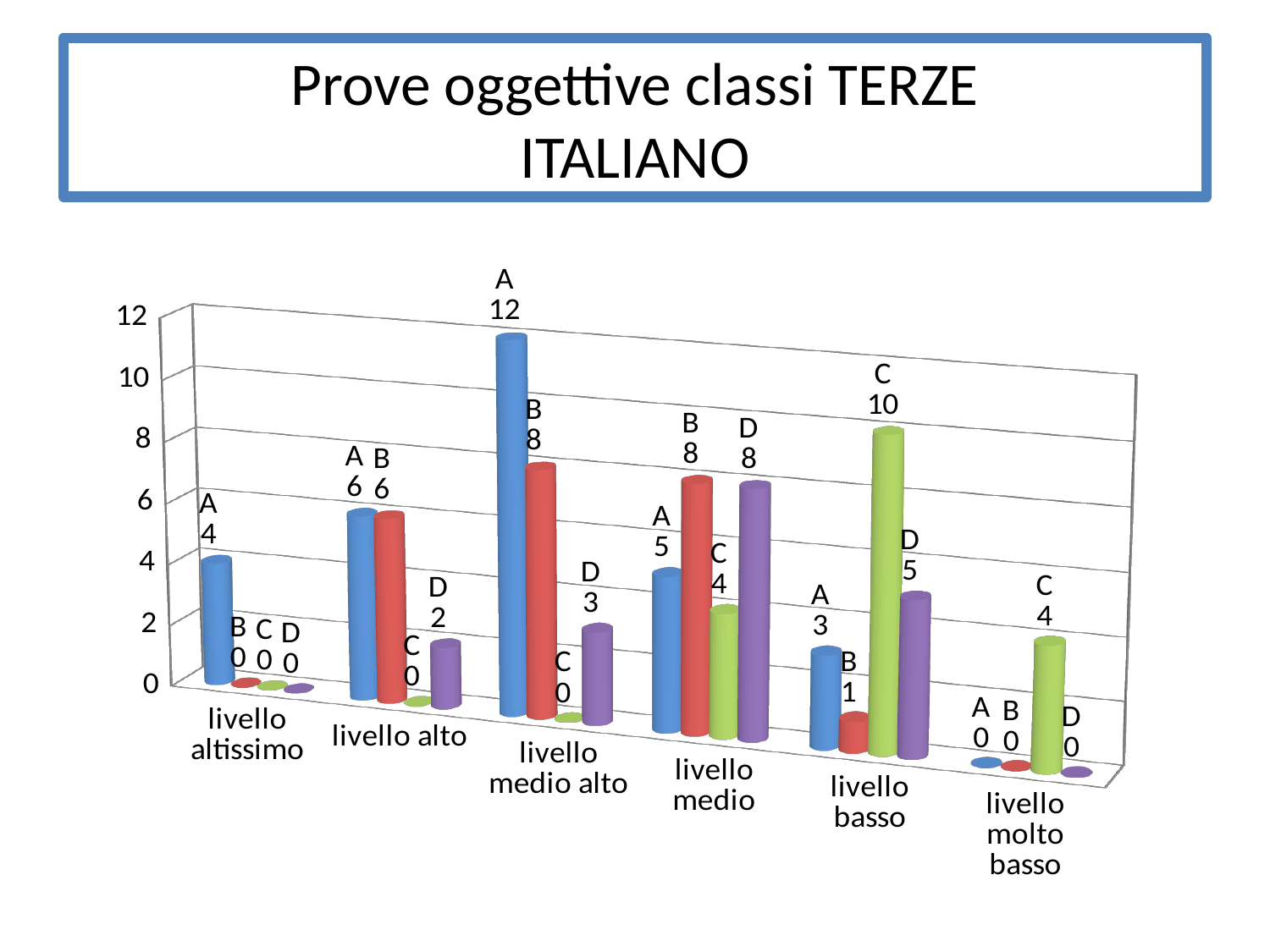
What is the value for class D at livello alto? 2 How many level categories are shown on the x axis? 6 What is the difference between class A and class B at livello medio alto? 4 What is the total of the four class values at livello molto basso? 4 Which is larger at livello medio: class A or class D? D What is the title of the slide containing the chart? Prove oggettive classi TERZE ITALIANO What is the value for class A at livello medio alto? 12 What is the value for class C at livello basso? 10 What is the value for class B at livello medio? 8 Which class has the lowest value at livello medio alto? C Which class has the highest value at livello basso? C What kind of chart is shown on the slide? bar chart